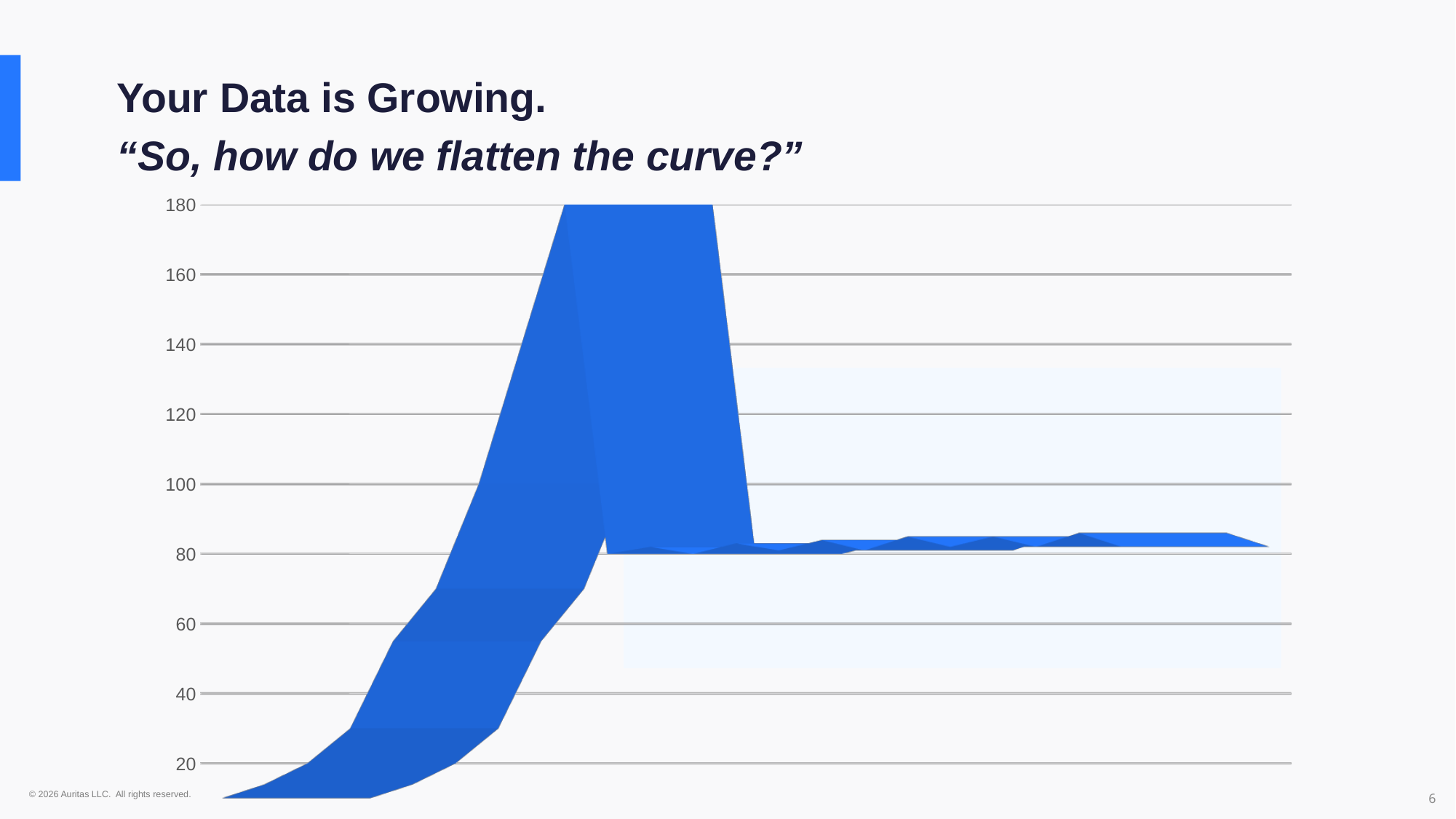
Is the starting value at the far left of the chart greater or less than 20? less Is the flat plateau on the right-hand side of the chart greater or less than 100? less What is the highest value labelled on the vertical axis? 180 What is the interval between consecutive labelled ticks on the vertical axis? 20 Do the values rise or fall along the left-hand portion of the chart, before the peak? rise Is the peak value of the plotted area greater or less than 160? greater After the sharp drop following the peak, do the values on the right-hand portion of the chart rise, fall, or stay roughly flat? stay roughly flat What kind of chart is shown on the slide? line chart (3D line)